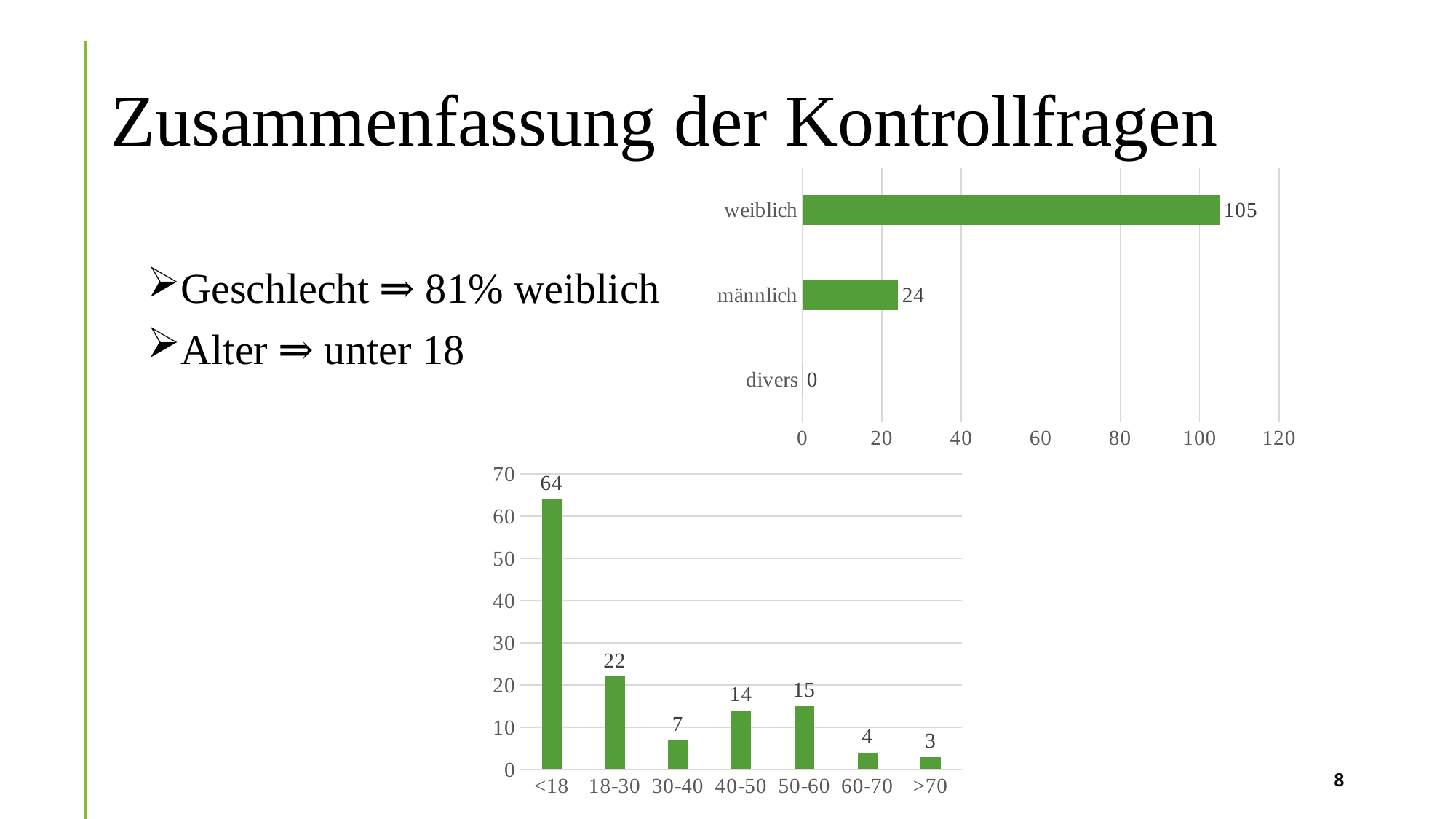
In the bottom age-group bar chart, what is the difference between 18-30 and 30-40? 15 In the bottom age-group bar chart, how many categories are shown on the x axis? 7 In the bottom age-group bar chart, what is the value for <18? 64 In the top-right horizontal bar chart, what is the value for männlich? 24 In the top-right horizontal bar chart, what is the value for weiblich? 105 In the bottom age-group bar chart, what is the value for 40-50? 14 In the top-right horizontal bar chart, what is the difference between weiblich and männlich? 81 What kind of chart is the top-right chart? bar chart In the top-right horizontal bar chart, what is the value for divers? 0 In the top-right horizontal bar chart, how many categories are shown? 3 In the bottom age-group bar chart, which category has the highest value? <18 In the bottom age-group bar chart, which category has the lowest value? >70